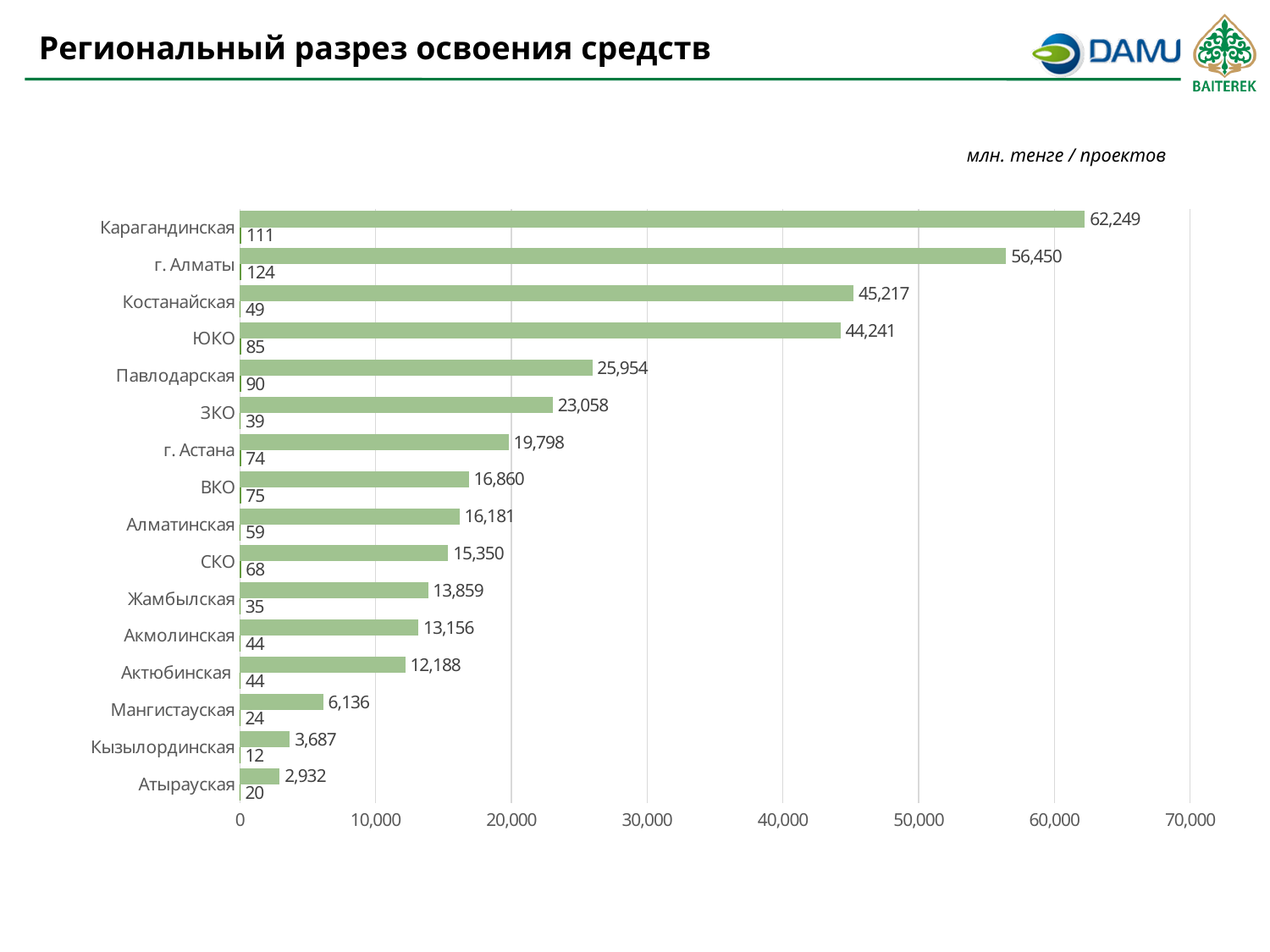
What type of chart is shown on the slide? bar chart Which region has the highest amount in млн. тенге? Карагандинская Which region has the lowest amount in млн. тенге? Атырауская How many regions are listed on the chart? 16 What is the amount in млн. тенге for Карагандинская? 62,249 What is the title of the slide? Региональный разрез освоения средств How many projects are shown for Кызылординская? 12 What is the amount in млн. тенге for Павлодарская? 25,954 How many projects (проектов) are shown for г. Алматы? 124 Which region has a larger amount in млн. тенге, Костанайская or ЮКО? Костанайская What is the difference in млн. тенге between Карагандинская and г. Алматы? 5,799 What is the difference in the number of projects between Карагандинская and Павлодарская? 21